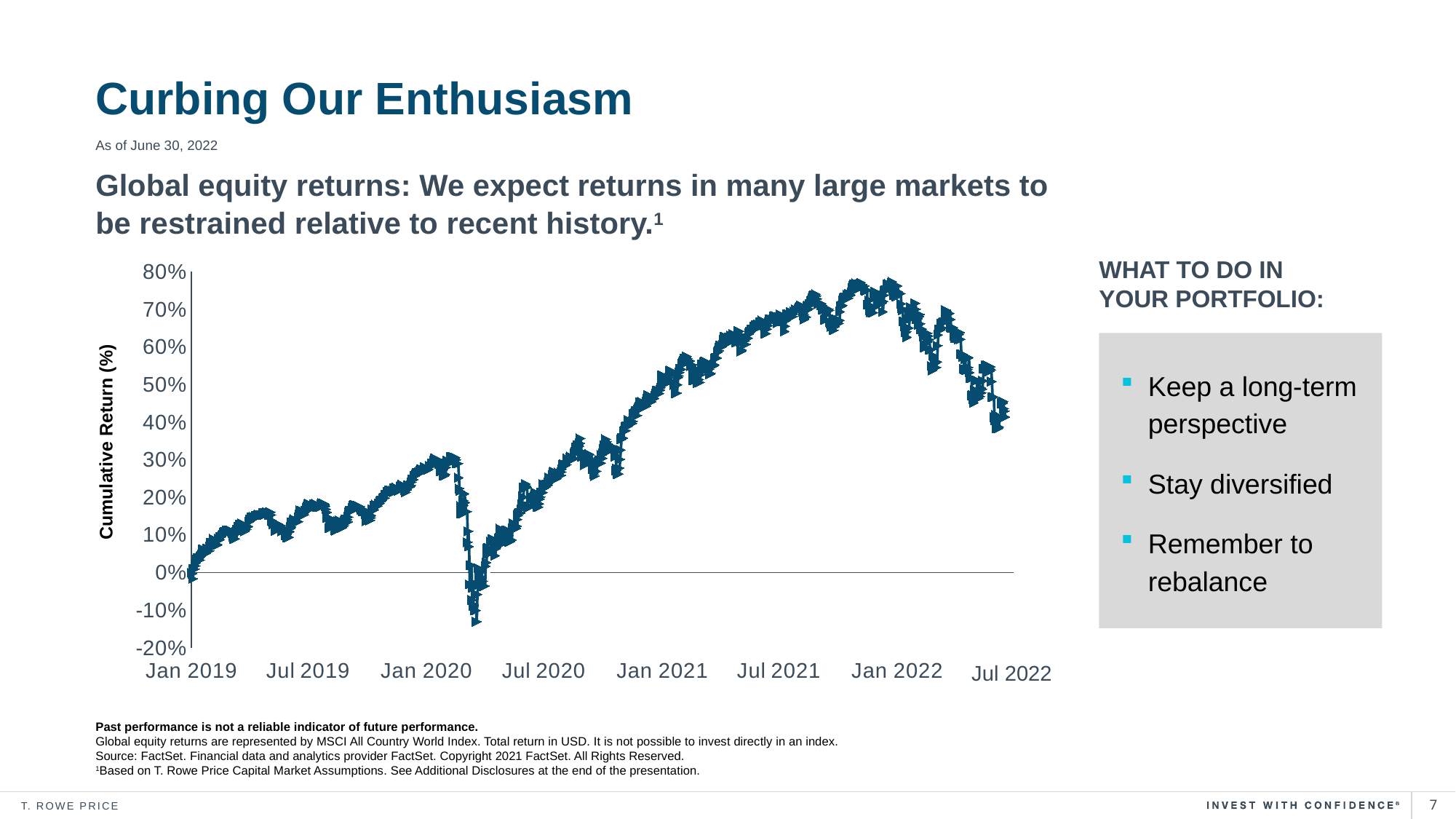
What is the label of the y-axis on the chart? Cumulative Return (%) Is the cumulative return around Jan 2022 greater or less than 60%? greater Between which two x-axis labels does the line reach its lowest point? Jan 2020 and Jul 2020 Is the lowest point of the line greater or less than 0%? less Is the cumulative return at Jul 2022 greater or less than 50%? less What is the highest value shown on the y-axis of the chart? 80% What is the cumulative return at the start of the series in Jan 2019? 0% How many date labels are shown along the x-axis of the chart? 8 Does the cumulative return rise or fall between Jul 2020 and Jul 2021? rise What kind of chart is shown on the slide? line chart Does the cumulative return rise or fall between Jan 2022 and Jul 2022? fall